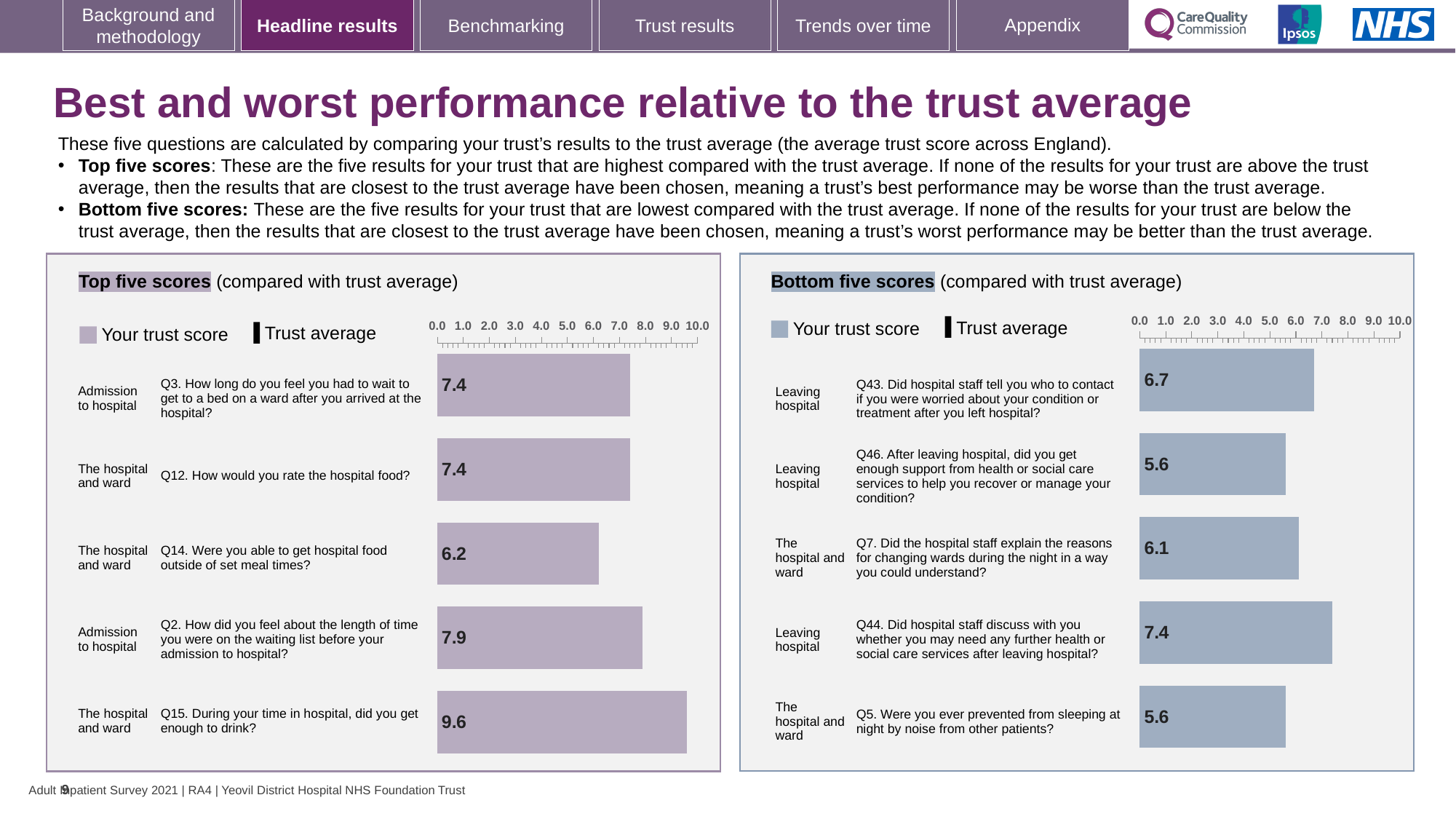
What kind of chart is the 'Top five scores' chart? Bar chart In the 'Top five scores' chart, what is the trust score for Q15 (During your time in hospital, did you get enough to drink?)? 9.6 In the 'Top five scores' chart, which has the larger trust score: Q2 or Q14? Q2 In the 'Bottom five scores' chart, what is the trust score for Q7 (Did the hospital staff explain the reasons for changing wards during the night in a way you could understand?)? 6.1 In the 'Top five scores' chart, which question has the lowest trust score? Q14. Were you able to get hospital food outside of set meal times? How many questions are shown in the 'Bottom five scores' chart? 5 In the 'Top five scores' chart, what is the difference between the trust scores for Q15 and Q14? 3.4 In the 'Bottom five scores' chart, what is the trust score for Q43 (Did hospital staff tell you who to contact if you were worried about your condition or treatment after you left hospital?)? 6.7 In the 'Bottom five scores' chart, which question has the highest trust score? Q44. Did hospital staff discuss with you whether you may need any further health or social care services after leaving hospital? In the 'Top five scores' chart, which question has the highest trust score? Q15. During your time in hospital, did you get enough to drink? In the 'Top five scores' chart, what is the trust score for Q12 (How would you rate the hospital food?)? 7.4 In the 'Bottom five scores' chart, what is the difference between the trust scores for Q44 and Q46? 1.8